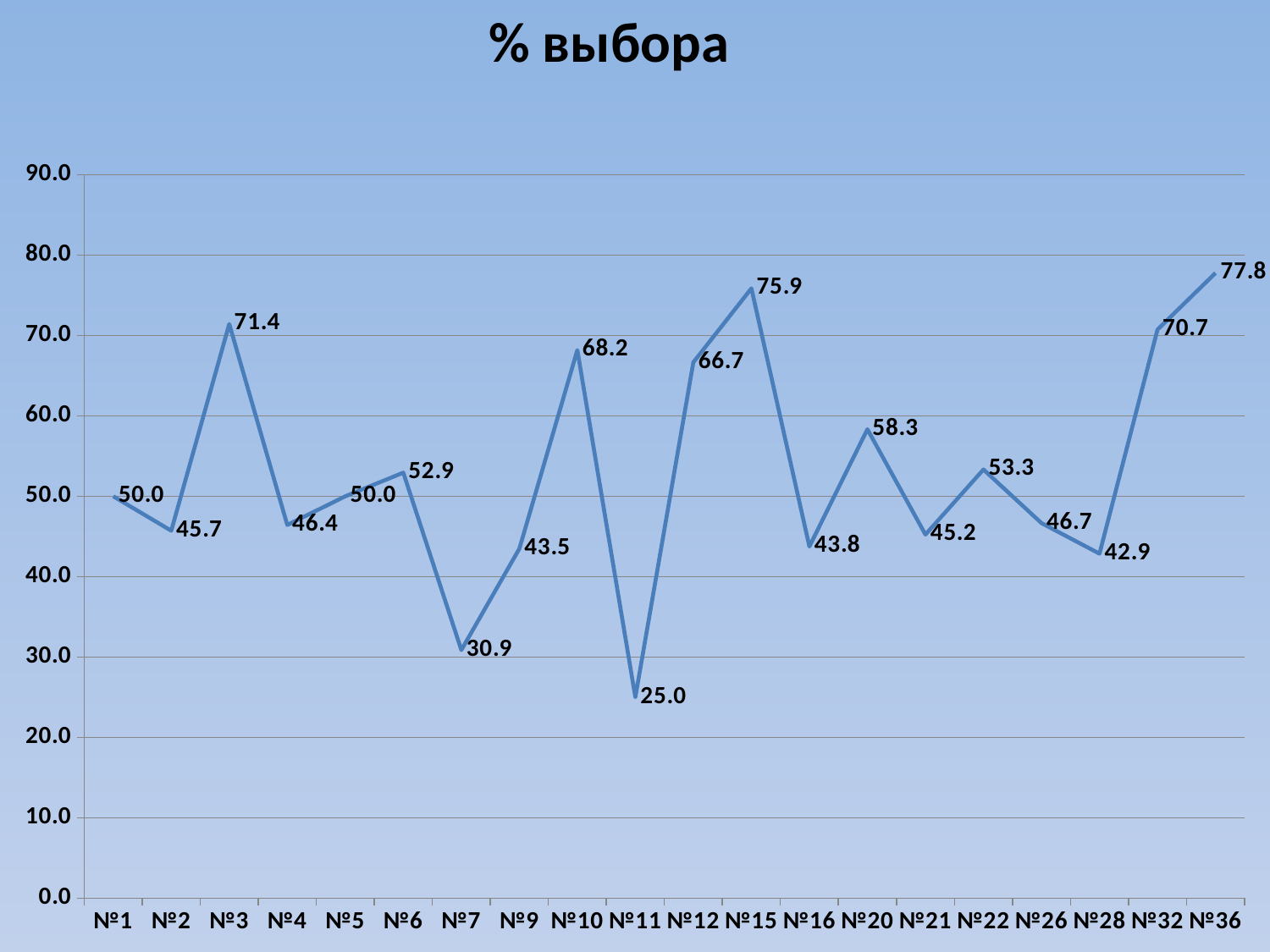
Which category has the highest value? №36 What kind of chart is shown on the slide? line chart What is the value for №32? 70.7 What is the title of the chart? % выбора How many categories are plotted on the x axis? 20 What is the value for №11? 25.0 What is the value for №3? 71.4 What is the value for №20? 58.3 Which is larger, the value for №10 or the value for №12? №10 What is the difference between the values for №15 and №16? 32.1 Which category has the lowest value? №11 Is the value for №7 greater or less than 40.0? less